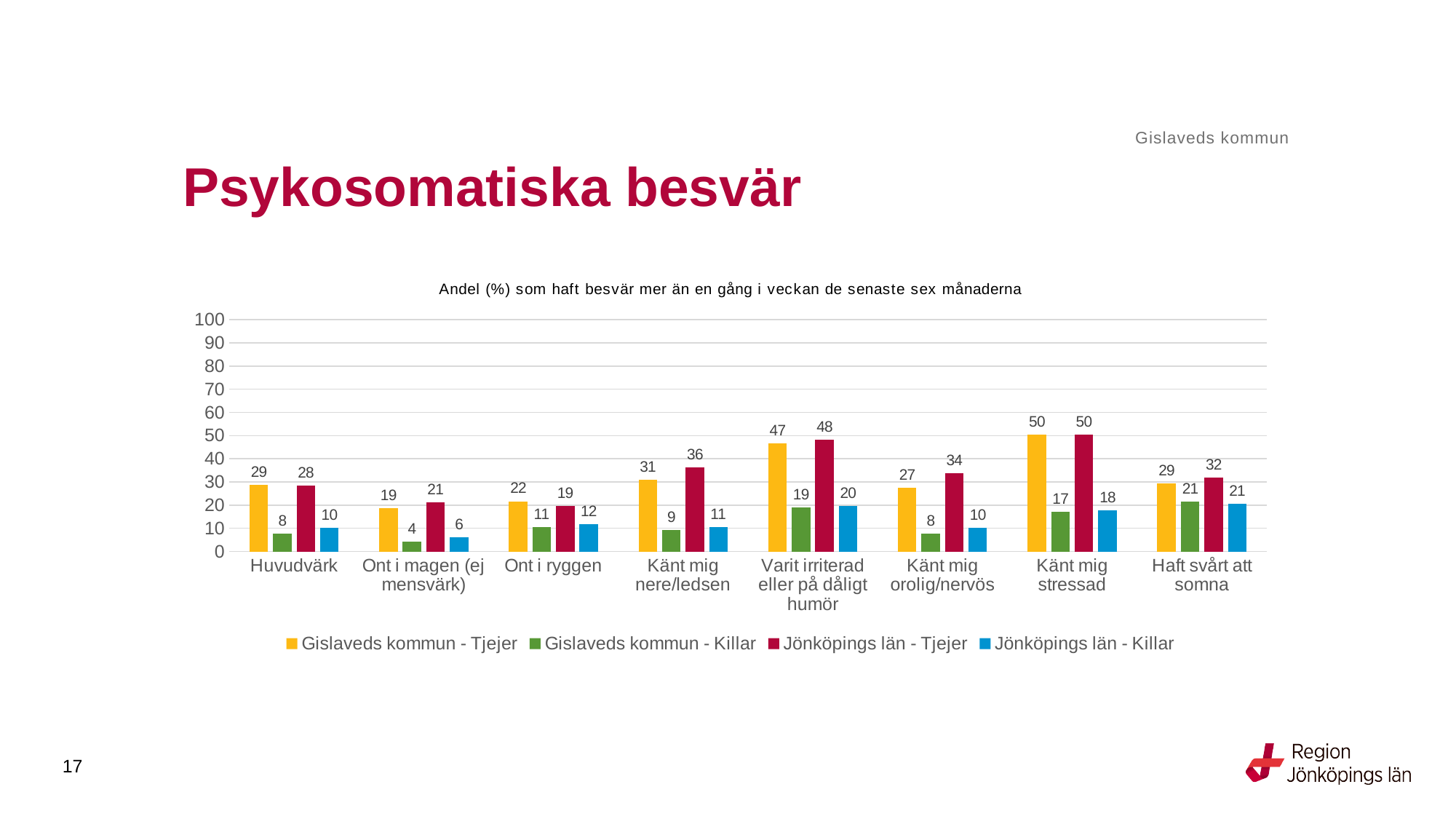
Which category has the highest value for Jönköpings län - Tjejer? Känt mig stressad How many series does the legend list? 4 How many categories are shown on the x axis? 8 What is the value for Jönköpings län - Killar for Haft svårt att somna? 21 What is the subtitle printed above the chart? Andel (%) som haft besvär mer än en gång i veckan de senaste sex månaderna What kind of chart is shown on the slide? Bar chart What is the value for Gislaveds kommun - Killar for Ont i magen (ej mensvärk)? 4 What is the value for Jönköpings län - Tjejer for Känt mig orolig/nervös? 34 Which category has the lowest value for Gislaveds kommun - Killar? Ont i magen (ej mensvärk) Which is larger for Ont i ryggen: Gislaveds kommun - Tjejer or Jönköpings län - Tjejer? Gislaveds kommun - Tjejer What is the value for Gislaveds kommun - Tjejer for Känt mig stressad? 50 What is the difference between Jönköpings län - Tjejer and Gislaveds kommun - Tjejer for Känt mig orolig/nervös? 7